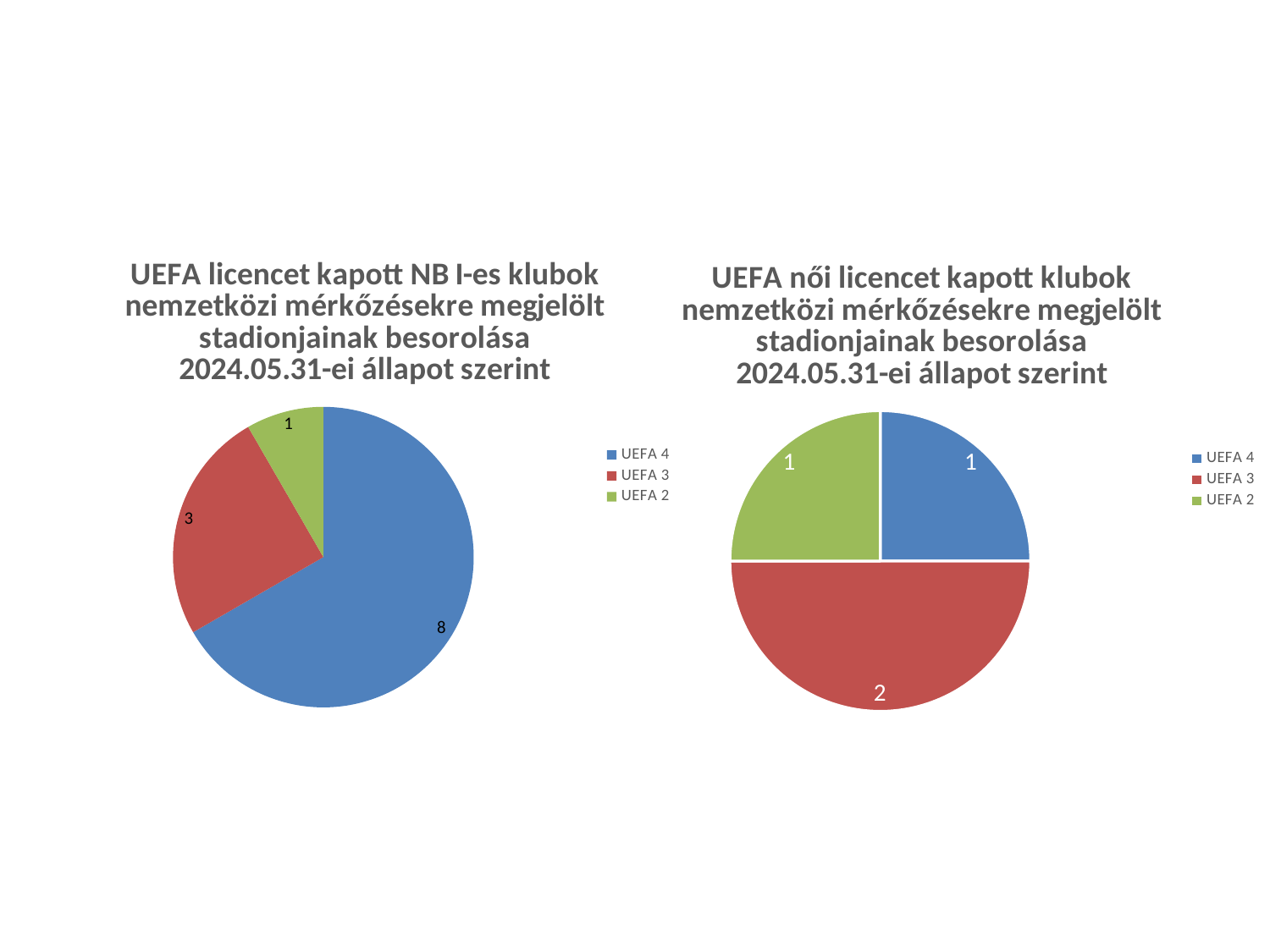
In the left chart (UEFA licencet kapott NB I-es klubok), which category has the largest slice? UEFA 4 In the right chart (UEFA női licencet kapott klubok), which category has the largest slice? UEFA 3 In the right chart (UEFA női licencet kapott klubok), what share of the pie does UEFA 3 represent? 50% In the left chart (UEFA licencet kapott NB I-es klubok), what is the difference between the UEFA 4 and UEFA 3 values? 5 In the left chart (UEFA licencet kapott NB I-es klubok), what is the value for UEFA 3? 3 In the left chart (UEFA licencet kapott NB I-es klubok), what is the total of all slices? 12 What type of chart is shown on the right side of the slide? Pie chart In the left chart (UEFA licencet kapott NB I-es klubok), which category has the smallest slice? UEFA 2 How many series does the legend of the left chart list? 3 In the left chart (UEFA licencet kapott NB I-es klubok), what is the value for UEFA 4? 8 In the right chart (UEFA női licencet kapott klubok), what is the value for UEFA 2? 1 In the right chart (UEFA női licencet kapott klubok), what is the value for UEFA 3? 2